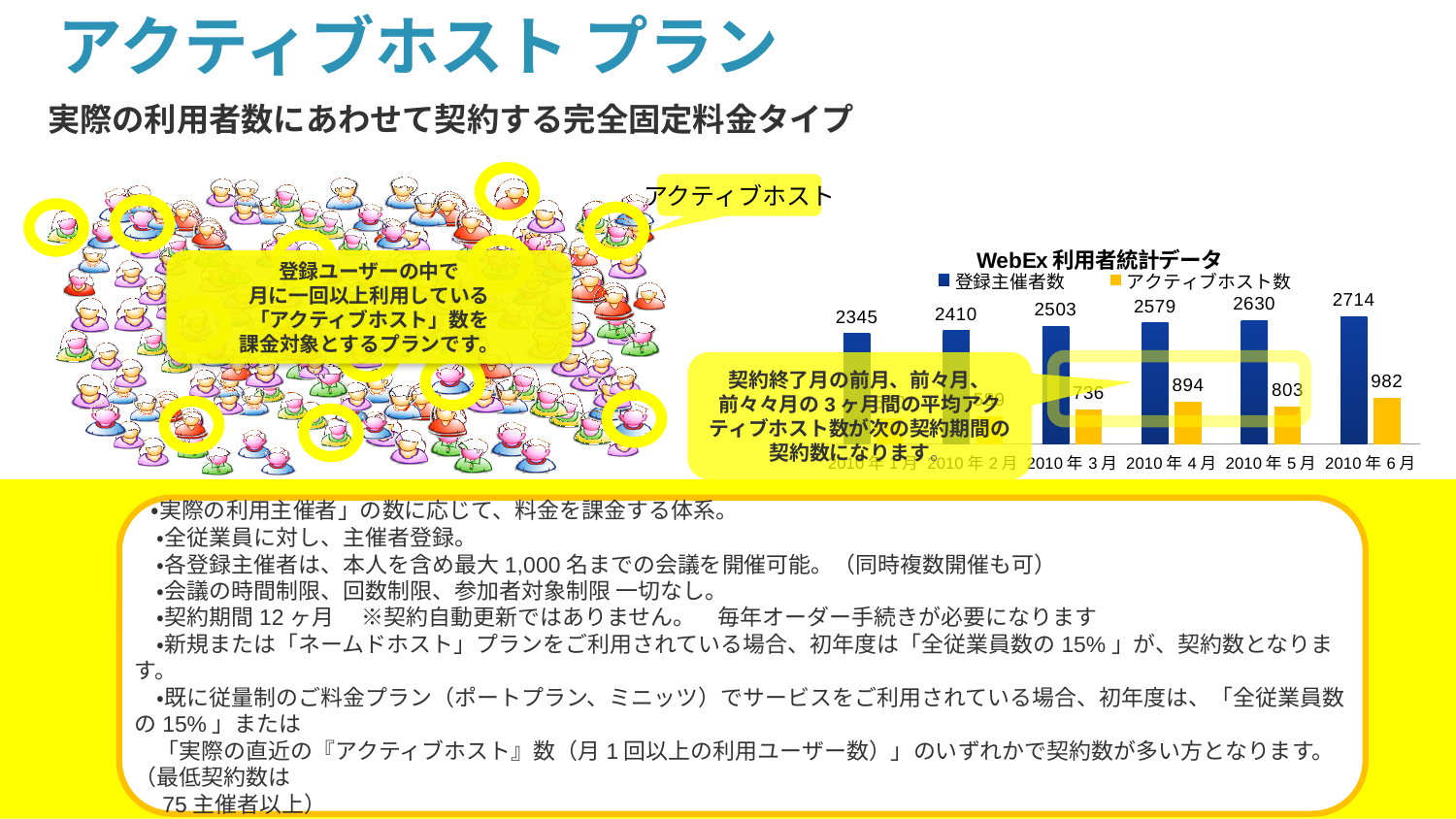
In the WebEx 利用者統計データ chart, what is the 登録主催者数 value for 2010年6月? 2714 In the WebEx 利用者統計データ chart, what is the difference between the 登録主催者数 for 2010年6月 and 2010年5月? 84 In the WebEx 利用者統計データ chart, which month has the lowest 登録主催者数? 2010年1月 How many series does the legend of the WebEx 利用者統計データ chart list? 2 In the WebEx 利用者統計データ chart, does the 登録主催者数 rise or fall from 2010年1月 to 2010年6月? rise In the WebEx 利用者統計データ chart, what is the 登録主催者数 value for 2010年3月? 2503 In the WebEx 利用者統計データ chart, which month has the highest 登録主催者数? 2010年6月 What kind of chart is the WebEx 利用者統計データ chart? bar chart In the WebEx 利用者統計データ chart, what is the アクティブホスト数 value for 2010年4月? 894 How many months are shown on the x axis of the WebEx 利用者統計データ chart? 6 In the WebEx 利用者統計データ chart, what is the difference between 登録主催者数 and アクティブホスト数 for 2010年6月? 1732 In the WebEx 利用者統計データ chart, which is larger, the アクティブホスト数 for 2010年4月 or for 2010年5月? 2010年4月